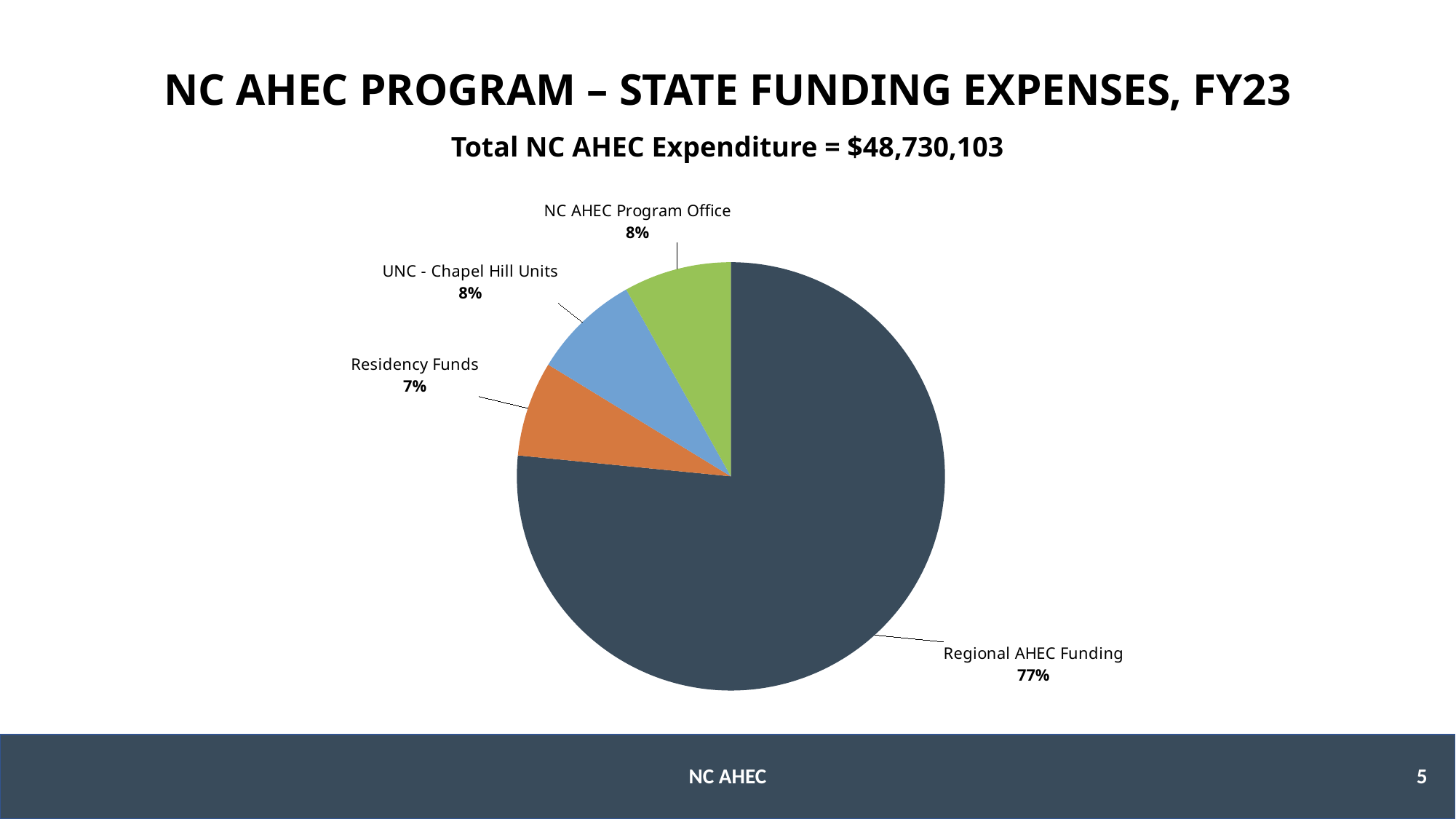
What share of the pie does Regional AHEC Funding represent? 77% What is the total NC AHEC expenditure stated on the slide? $48,730,103 What share of the pie does NC AHEC Program Office represent? 8% Which is larger, the share for Regional AHEC Funding or the share for NC AHEC Program Office? Regional AHEC Funding How many slices does the pie chart have? 4 What kind of chart is shown on the slide? pie chart What colour is the Regional AHEC Funding slice? dark blue-grey Which category has the smallest slice of the pie? Residency Funds What share of the pie does Residency Funds represent? 7% What is the difference in percentage points between Regional AHEC Funding and Residency Funds? 70 Which category has the largest slice of the pie? Regional AHEC Funding